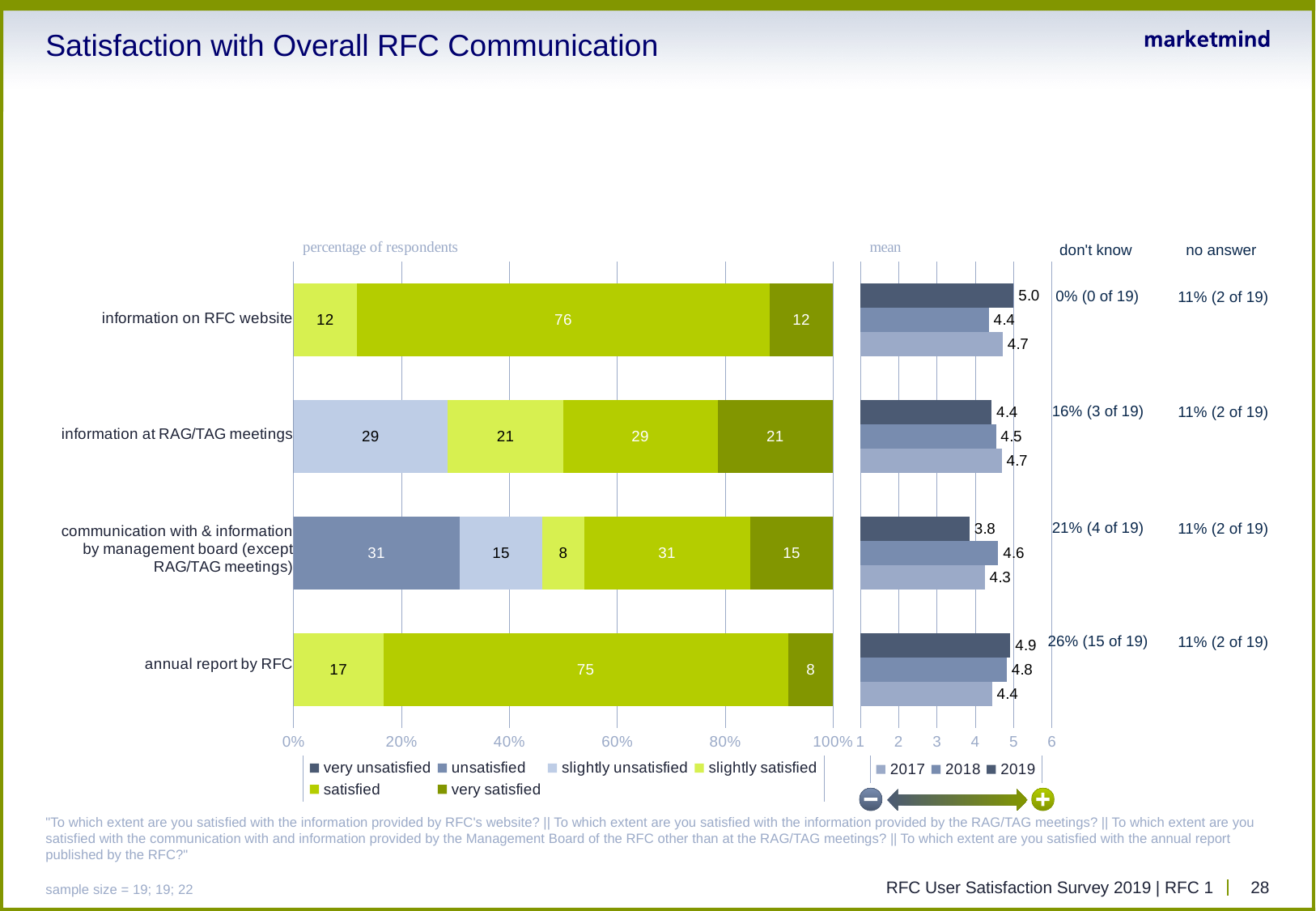
In the percentage of respondents chart, how many categories are shown on the vertical axis? 4 In the percentage of respondents chart, what percentage of respondents were satisfied with information on RFC website? 76 In the mean chart, what is the 2019 mean for information on RFC website? 5.0 In the mean chart, what is the difference between the 2019 mean and the 2018 mean for information on RFC website? 0.6 In the mean chart, how many series does the legend list? 3 In the percentage of respondents chart, what percentage of respondents were unsatisfied with communication with & information by management board (except RAG/TAG meetings)? 31 In the percentage of respondents chart, what percentage of respondents were very satisfied with annual report by RFC? 8 In the percentage of respondents chart, what percentage of respondents were slightly unsatisfied with information at RAG/TAG meetings? 29 What kind of chart is the percentage of respondents chart? stacked bar chart In the percentage of respondents chart, how many series does the legend list? 6 In the mean chart, which category has the lowest 2019 mean? communication with & information by management board (except RAG/TAG meetings) In the mean chart, what is the 2018 mean for communication with & information by management board (except RAG/TAG meetings)? 4.6